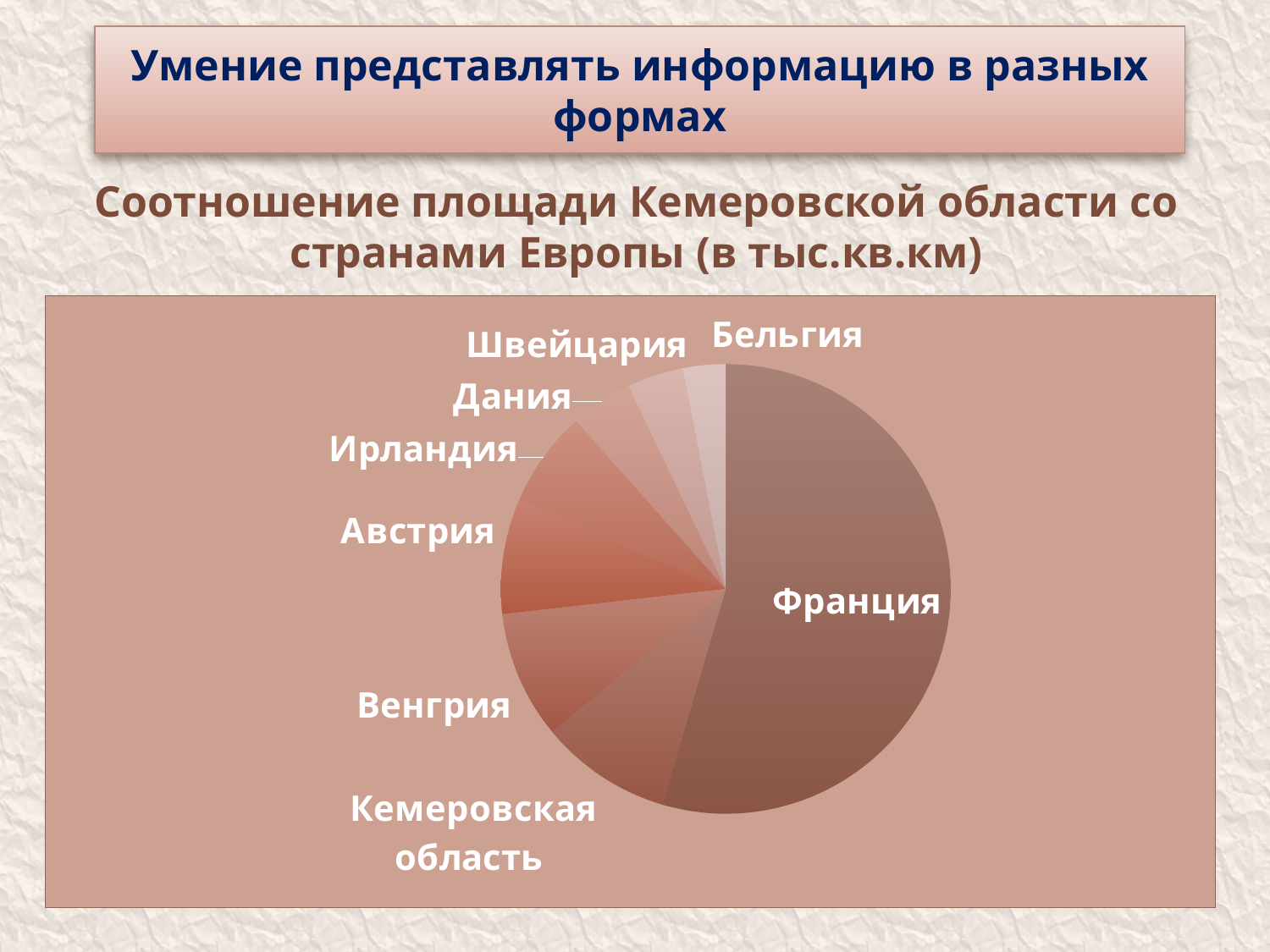
Which is larger in the pie chart, Венгрия or Дания? Венгрия Which category's label is split across two lines below the pie chart? Кемеровская область Which is larger in the pie chart, Австрия or Ирландия? Австрия What is the title of the chart on the slide? Соотношение площади Кемеровской области со странами Европы (в тыс.кв.км) Which category has the largest slice of the pie chart? Франция Which is larger in the pie chart, Кемеровская область or Швейцария? Кемеровская область What kind of chart is shown on the slide? pie chart How many slices does the pie chart have? 8